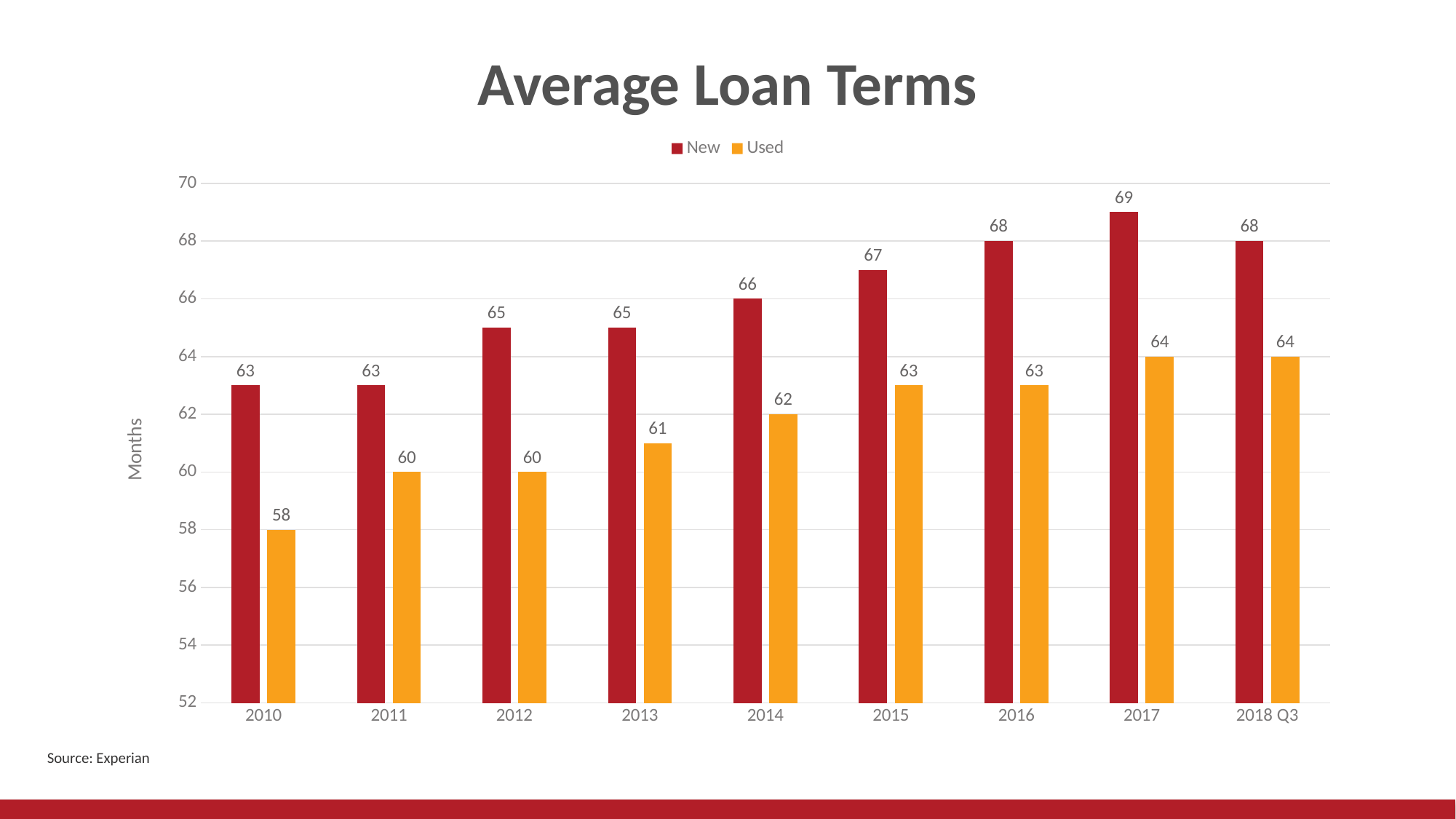
What is the value for Used in 2018 Q3? 64 Which is larger in 2013, the New or the Used loan term? New How many time periods are shown on the x axis? 9 What is the average loan term for Used vehicles in 2010? 58 Does the Used loan term generally rise or fall from 2010 to 2018 Q3? Rise What is the difference between the New and Used loan terms in 2010? 5 What is the average loan term for New vehicles in 2014? 66 In which year is the New loan term highest? 2017 How many series does the legend list? 2 What kind of chart is shown on the slide? Bar chart By how much did the New loan term increase from 2010 to 2017? 6 In which year is the Used loan term lowest? 2010